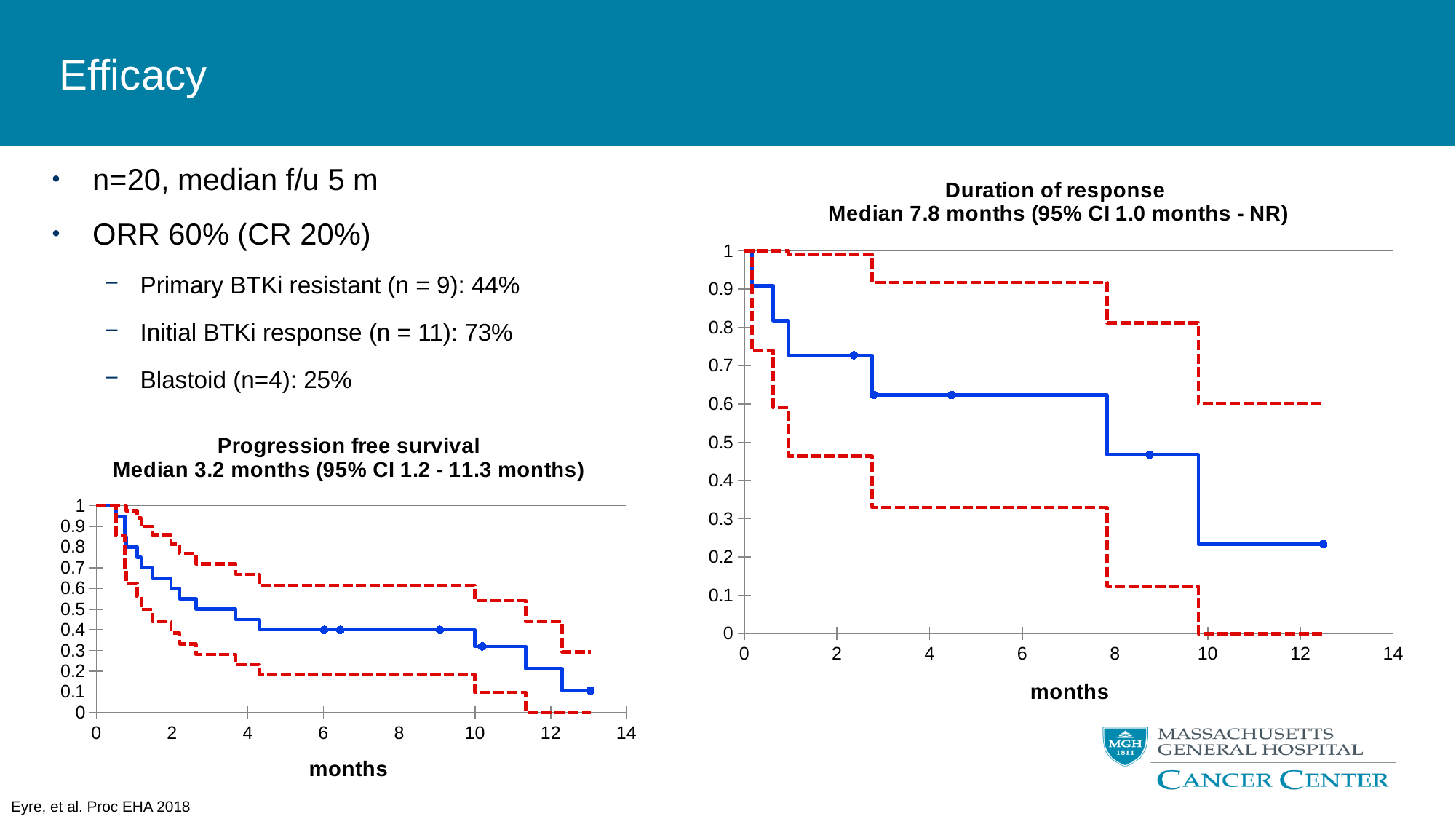
What is the x-axis label of the Progression free survival chart? months In the Duration of response chart, does the solid blue curve rise or fall as months increase? fall In the Duration of response chart, is the lower dashed red curve at 6 months greater or less than 0.4? less In the Duration of response chart, is the value of the solid blue curve at 6 months greater or less than 0.5? greater In the Progression free survival chart, is the value of the solid blue curve at 8 months greater or less than 0.5? less In the Progression free survival chart, does the solid blue curve rise or fall along the x axis? fall What kind of chart is the Progression free survival chart? line chart What median value is stated in the title of the Duration of response chart? 7.8 months